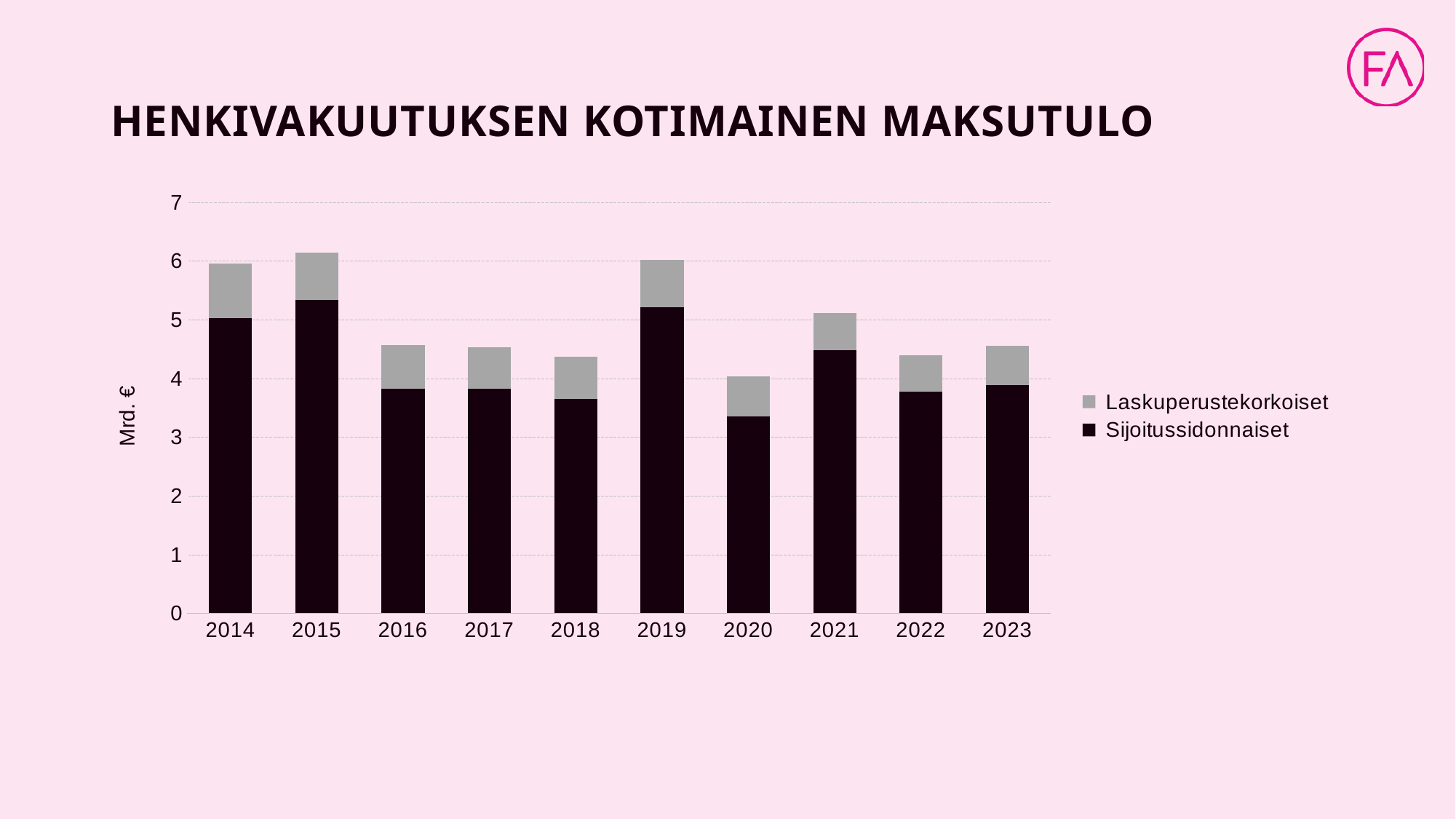
Is the total bar for 2016 greater or less than 4? greater Which year has the highest total bar in the chart? 2015 What kind of chart is shown on the slide? bar chart Which year has the lowest total bar in the chart? 2020 How many series does the chart's legend list? 2 Is the Sijoitussidonnaiset value for 2020 greater or less than 4? less What is the label on the y axis of the chart? Mrd. € Is the Sijoitussidonnaiset value for 2018 greater or less than 3? greater Which year has the larger total bar, 2021 or 2022? 2021 How many years are shown on the x axis of the chart? 10